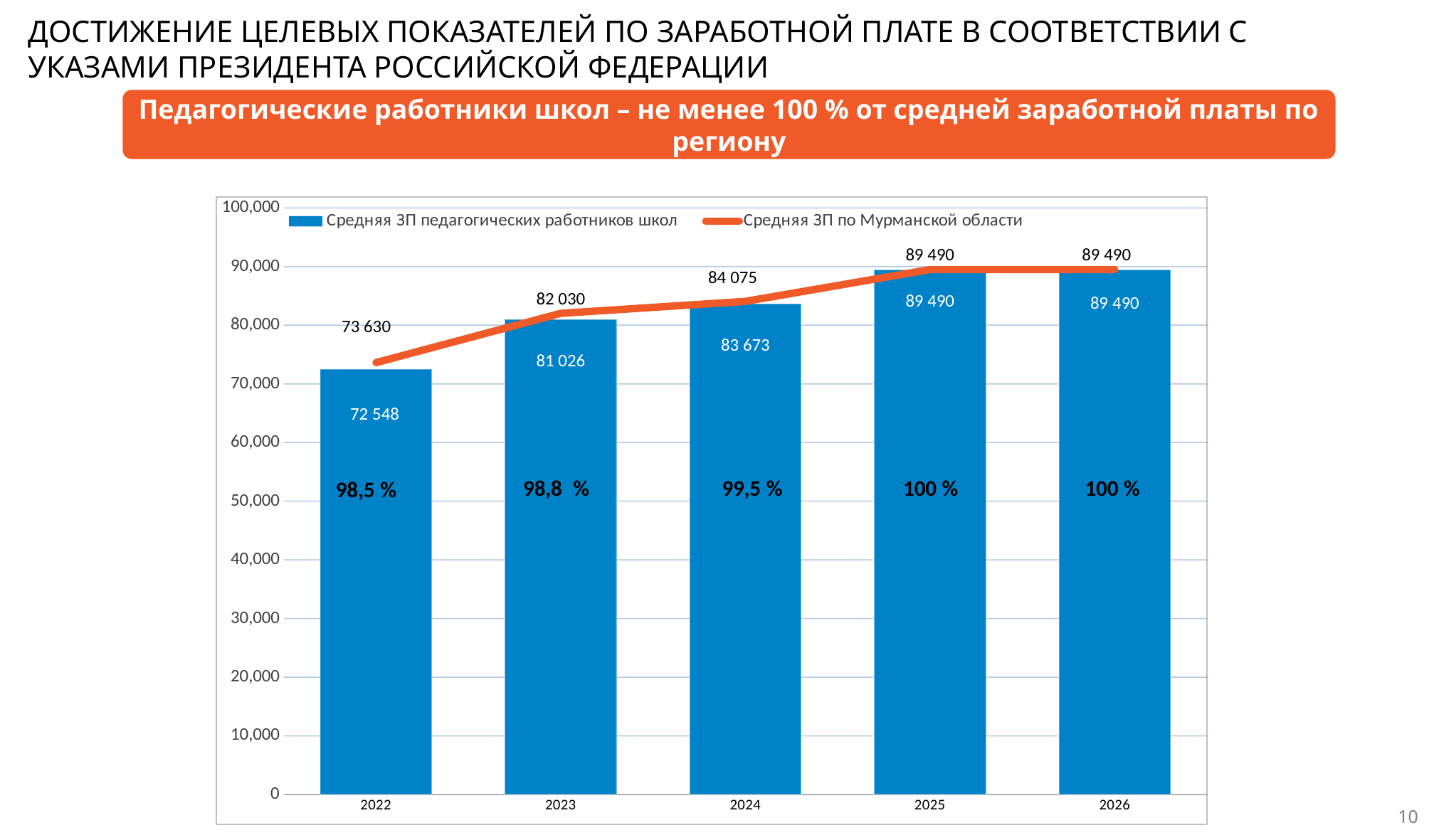
What is the value of the line series (Средняя ЗП по Мурманской области) for 2023? 82 030 Do the bar values rise or fall from 2022 to 2025? rise What percentage is printed inside the bar for 2022? 98,5 % How many series does the legend list? 2 Which is larger for 2024: the bar value or the line value? the line value (84 075) Which year has the lowest bar value for Средняя ЗП педагогических работников школ? 2022 What is the difference between the line value (73 630) and the bar value (72 548) for 2022? 1 082 What is the value of the bar for 2024? 83 673 Is the bar value for 2023 greater or less than 80,000? greater What colour is the line for Средняя ЗП по Мурманской области? orange How many years are shown on the x axis? 5 What is the value of the bar for 2022 (Средняя ЗП педагогических работников школ)? 72 548